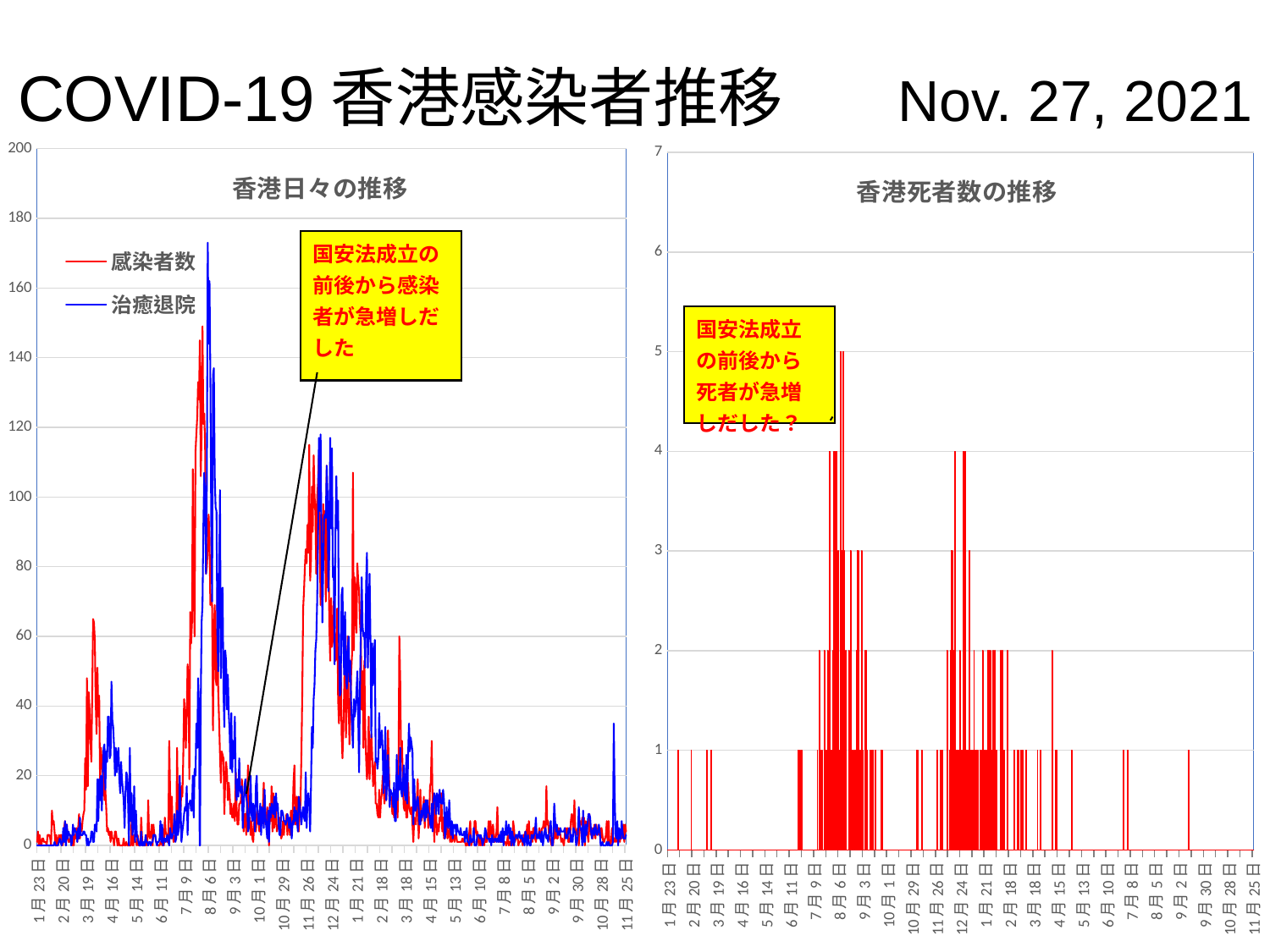
What kind of chart is the right chart titled 香港死者数の推移? bar chart In the left chart 香港日々の推移, what colour is the 感染者数 line? red In the left chart 香港日々の推移, is the peak of the 治癒退院 line around 8月6日 greater or less than 160? greater In the left chart 香港日々の推移, is the peak of the 感染者数 line around 8月6日 greater or less than 120? greater In the left chart 香港日々の推移, does the 感染者数 line generally rise or fall between 1月21日 and 5月13日? fall In the left chart 香港日々の推移, is the peak of the 感染者数 line around 3月19日 greater or less than 80? less In the right chart 香港死者数の推移, what is the highest daily value reached by any bar? 5 In the left chart 香港日々の推移, which series reaches the higher overall peak, 感染者数 or 治癒退院? 治癒退院 In the left chart 香港日々の推移, what are the two legend entries? 感染者数, 治癒退院 What kind of chart is the left chart titled 香港日々の推移? line chart In the left chart 香港日々の推移, how many series does the legend list? 2